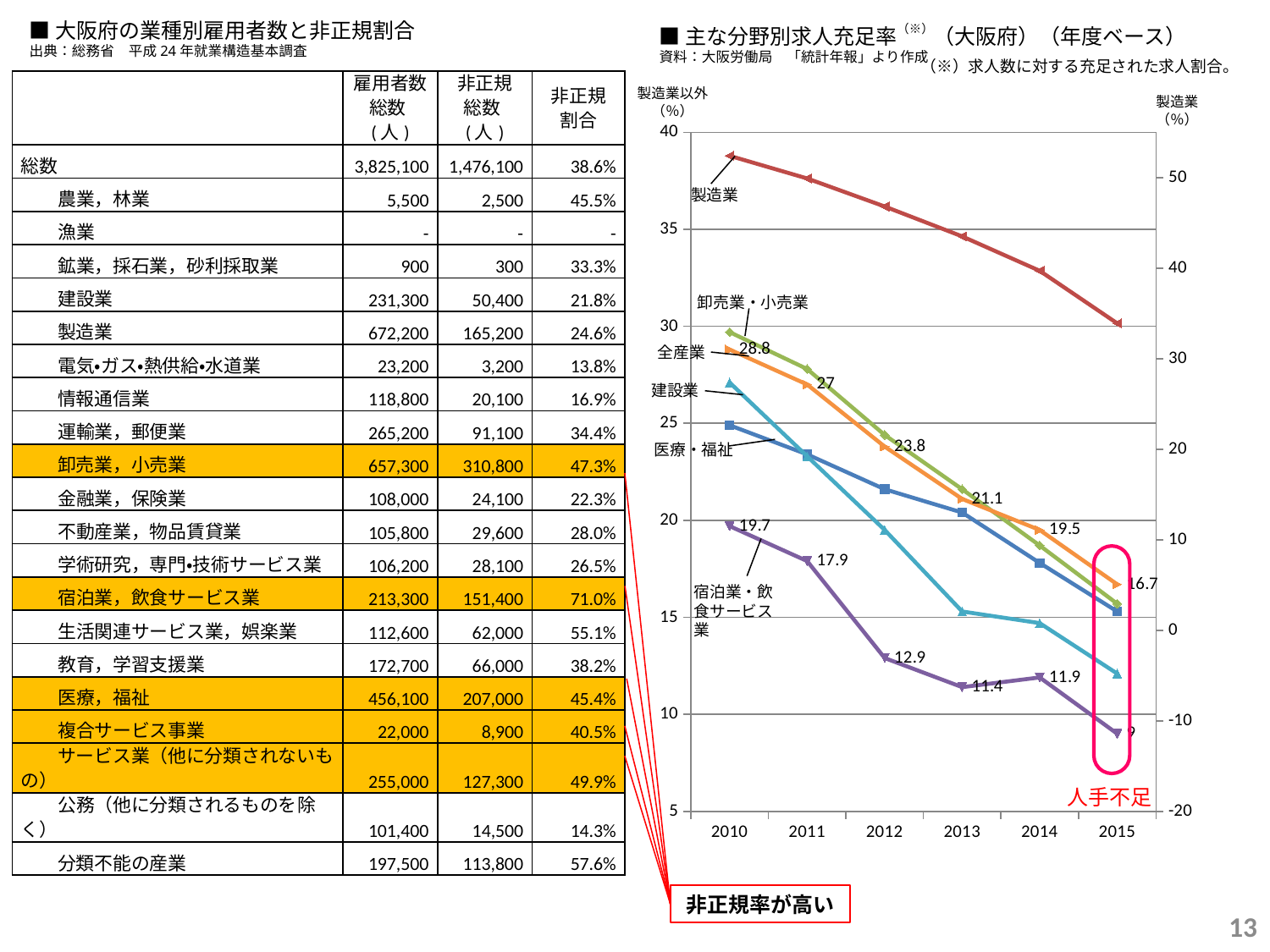
How many years are plotted on the x axis of the line chart on the right? 6 In the line chart on the right, does the 製造業 line rise or fall from 2010 to 2015? fall In the line chart on the right, by how much did the 全産業 value fall from 2010 to 2015? 12.1 In the line chart on the right, what is the value for 全産業 in 2010? 28.8 In the line chart on the right, is the value for 建設業 in 2015 greater or less than 15? less In the line chart on the right, what is the value for 宿泊業・飲食サービス業 in 2012? 12.9 In the line chart on the right, which is larger for 宿泊業・飲食サービス業: the 2013 value or the 2014 value? 2014 What kind of chart is shown on the right side of the slide? line chart What red annotation text is written near the 2015 values in the line chart on the right? 人手不足 In the line chart on the right, in which year is the 全産業 value highest? 2010 In the line chart on the right, what is the value for 宿泊業・飲食サービス業 in 2010? 19.7 In the line chart on the right, what is the value for 全産業 in 2015? 16.7